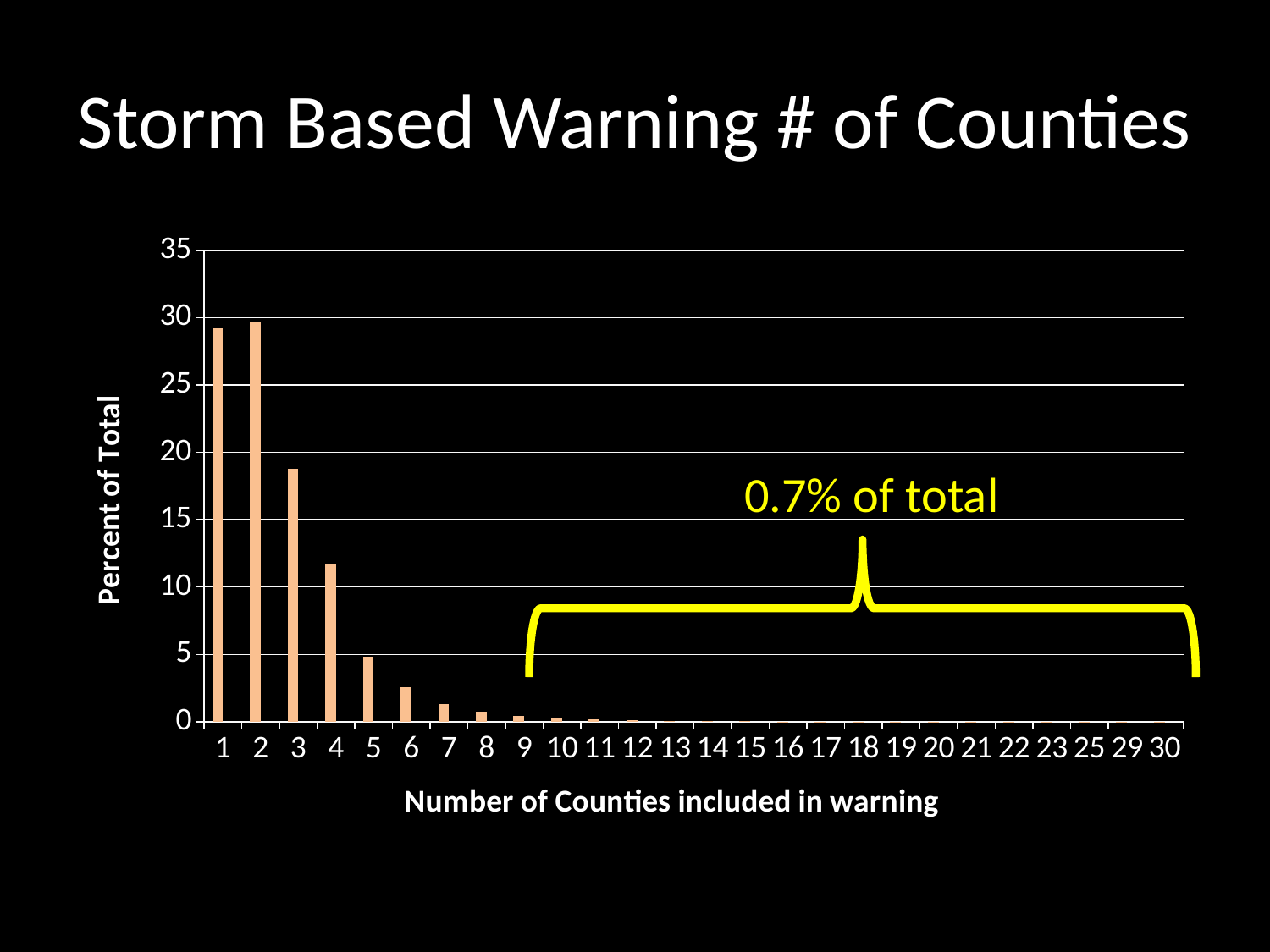
Which has a larger value, 1 county or 3 counties? 1 county Which has a larger value, 3 counties or 4 counties? 3 counties What is the title of the chart? Storm Based Warning # of Counties Do the values generally rise or fall as the number of counties increases along the x axis? fall What kind of chart is shown on the slide? bar chart Is the value for 5 counties greater or less than 10? less What is the label of the y axis? Percent of Total Is the value for 1 county greater or less than 25? greater Is the value for 6 counties greater or less than 5? less How many categories are shown on the x axis of the chart? 26